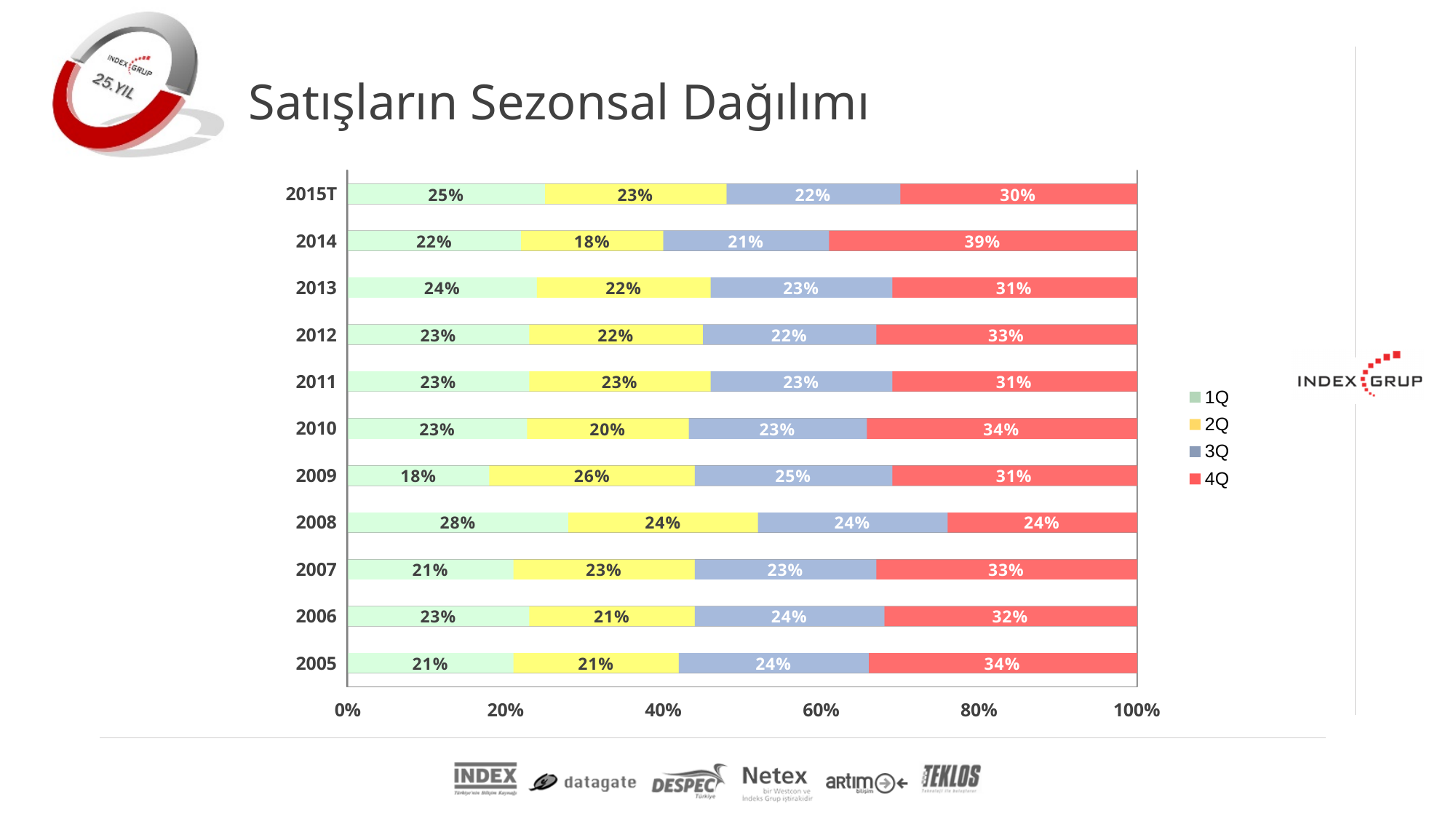
How many series does the legend list? 4 What kind of chart is shown on the slide? Stacked bar chart What is the 4Q share for 2014? 39% What is the 2Q share for 2009? 26% Which year has the larger 2Q share, 2009 or 2010? 2009 Which year has the highest 4Q share? 2014 Which year has the lowest 1Q share? 2009 How many years are shown on the chart? 11 In 2014, how much larger is the 4Q share than the 1Q share? 17 percentage points What is the title of the slide? Satışların Sezonsal Dağılımı What is the 1Q share for 2008? 28% What is the total of the stacked bar for 2008? 100%